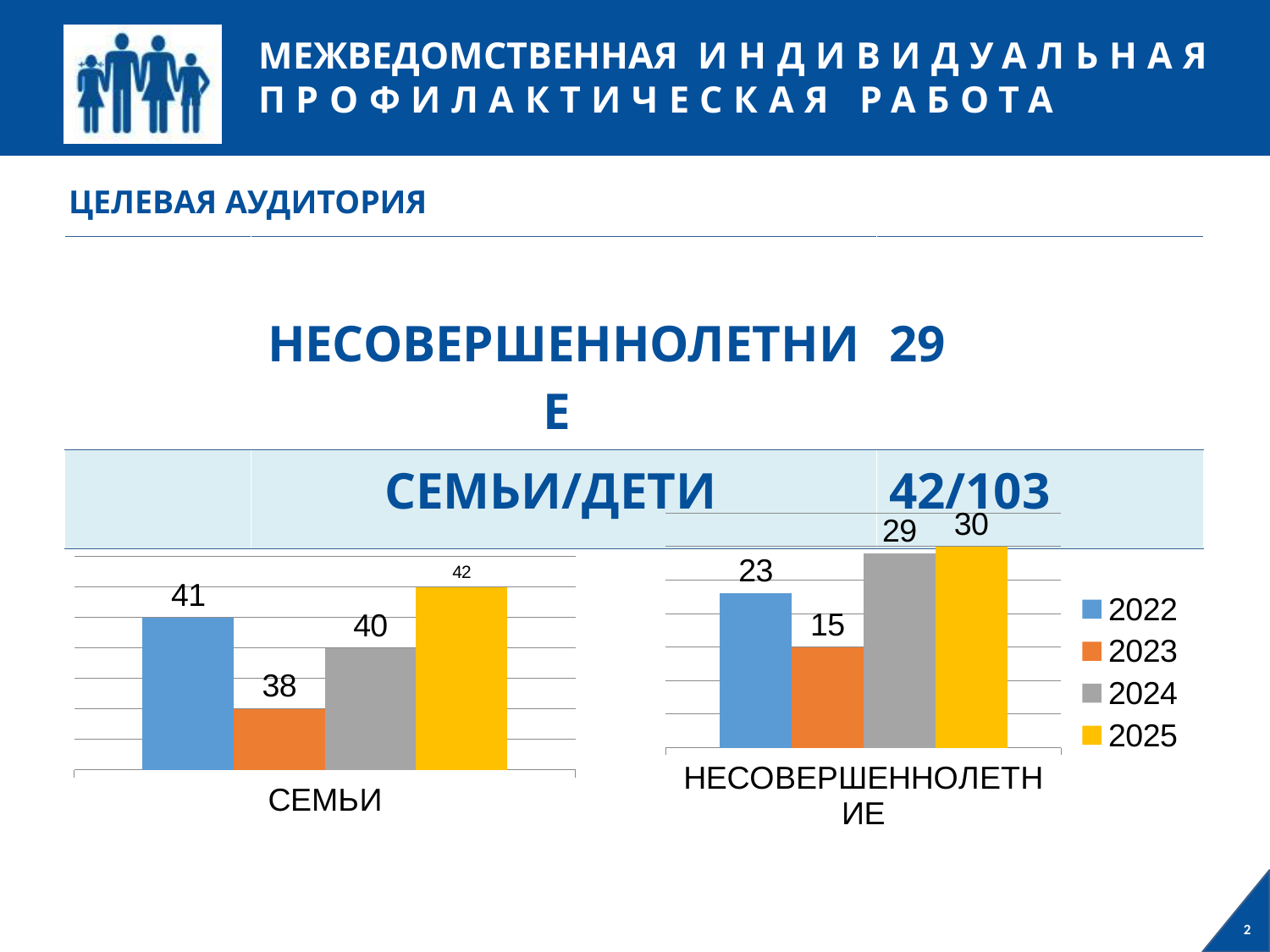
In the left chart (СЕМЬИ), what is the value for 2023? 38 How many series does the legend list? 4 In the right chart (НЕСОВЕРШЕННОЛЕТНИЕ), what is the value for 2025? 30 In the left chart (СЕМЬИ), which year has the highest value? 2025 In the right chart (НЕСОВЕРШЕННОЛЕТНИЕ), which is larger, the value for 2022 or the value for 2024? 2024 In the right chart (НЕСОВЕРШЕННОЛЕТНИЕ), what is the value for 2023? 15 In the left chart (СЕМЬИ), what is the difference between the 2025 and 2023 values? 4 Which colour represents 2025 in the legend? yellow In the left chart (СЕМЬИ), what is the value for 2022? 41 In the right chart (НЕСОВЕРШЕННОЛЕТНИЕ), what is the difference between the 2024 and 2023 values? 14 What kind of chart is the left chart (СЕМЬИ)? bar chart In the right chart (НЕСОВЕРШЕННОЛЕТНИЕ), which year has the lowest value? 2023